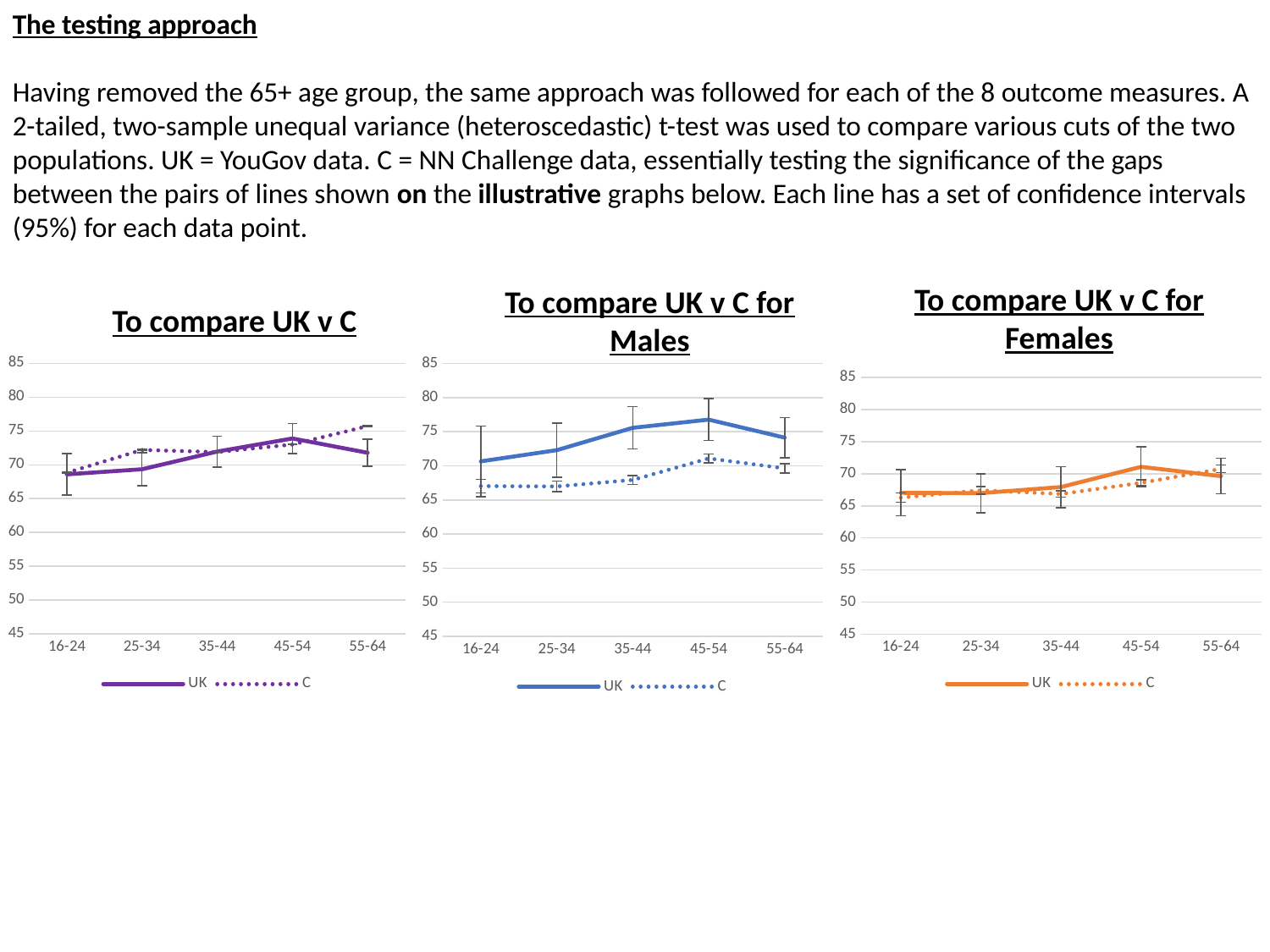
In the "To compare UK v C for Females" chart, which age group has the highest UK value? 45-54 In the "To compare UK v C for Males" chart, does the UK line rise or fall from 16-24 to 45-54? rise In the "To compare UK v C for Males" chart, which age group has the highest UK value? 45-54 In the "To compare UK v C" chart, which age group has the highest C value? 55-64 In the "To compare UK v C for Males" chart, which series has the larger value at 35-44, UK or C? UK In the "To compare UK v C for Males" chart, is the C value for 16-24 greater or less than 70? less In the "To compare UK v C for Males" chart, is the UK value for 45-54 greater or less than 75? greater What kind of chart is "To compare UK v C for Males"? line chart How many age groups are shown on the x axis of the "To compare UK v C" chart? 5 In the "To compare UK v C for Males" chart, which age group has the lowest UK value? 16-24 How many series does the legend of the "To compare UK v C for Females" chart list? 2 Which series is drawn with a dotted line in the "To compare UK v C" chart? C